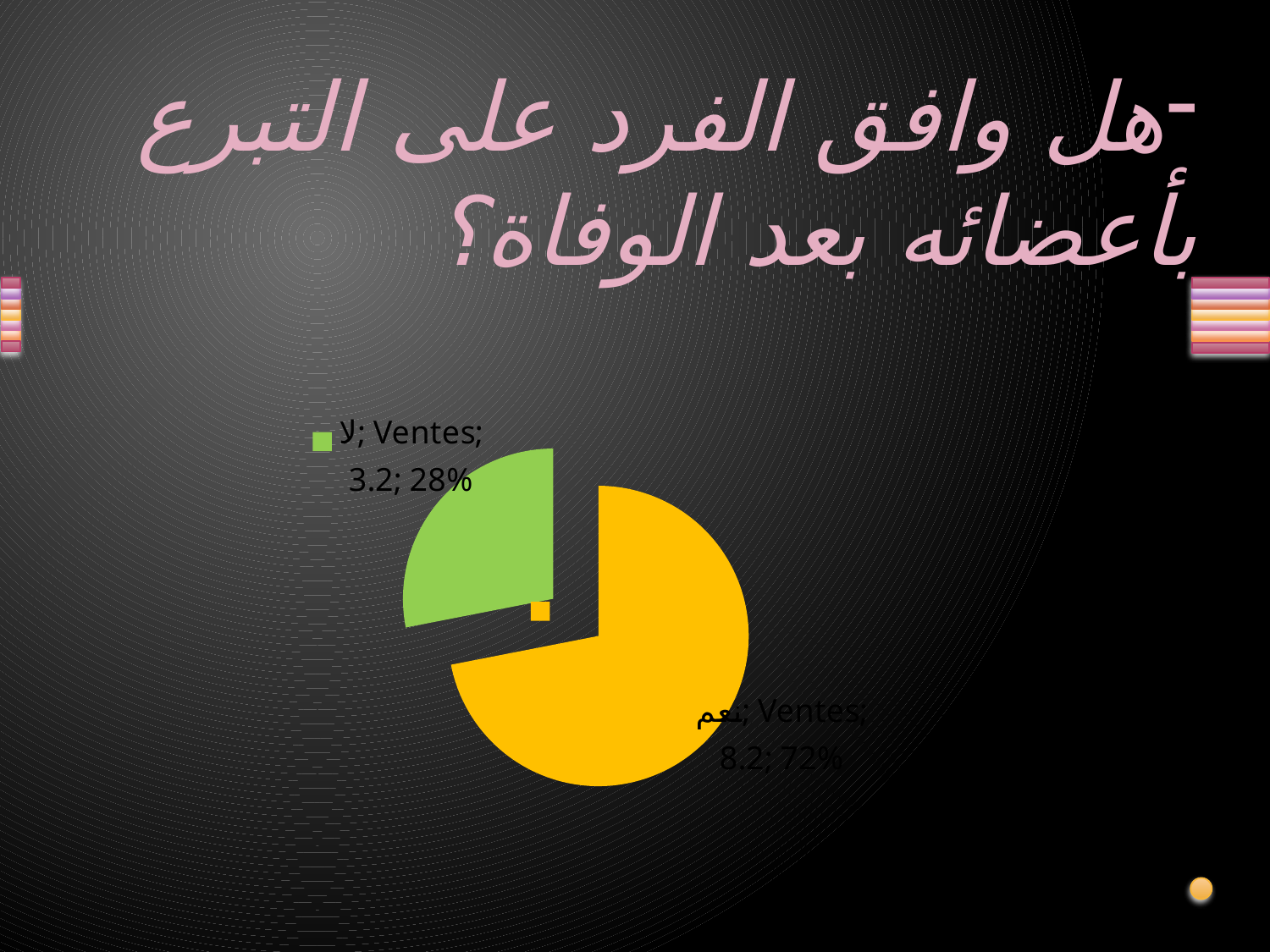
What kind of chart is shown on the slide? pie chart Which slice of the pie chart is the largest? نعم What is the difference between the Ventes values of "نعم" and "لا"? 5.0 What colour is the "نعم" slice in the pie chart? yellow What is the Ventes value for the "لا" slice? 3.2 What colour is the "لا" slice in the pie chart? green What is the Ventes value for the "نعم" slice? 8.2 Which slice of the pie chart is the smallest? لا What percentage share does the "نعم" slice have in the pie chart? 72% Which slice is larger, "نعم" or "لا"? نعم What percentage share does the "لا" slice have in the pie chart? 28% How many slices does the pie chart have? 2